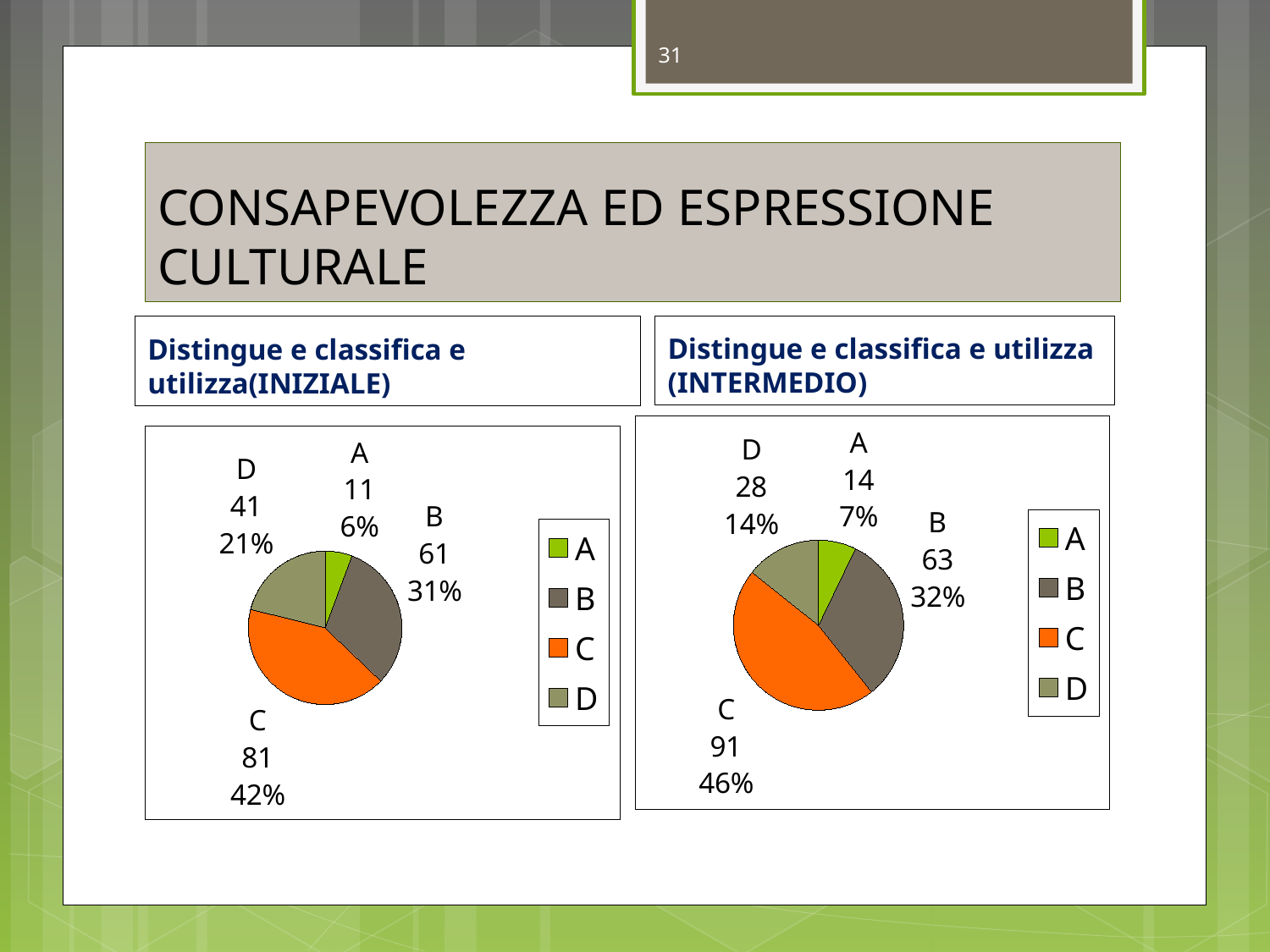
In the right pie chart (INTERMEDIO), which category has the smallest slice? A What colour is the slice for category C in the right pie chart (INTERMEDIO)? Orange In the left pie chart (INIZIALE), which is larger, the value for B or the value for D? B In the right pie chart (INTERMEDIO), what is the value for category A? 14 In the right pie chart (INTERMEDIO), what percentage share does category D have? 14% In the right pie chart (INTERMEDIO), what is the difference between the values for C and B? 28 In the left pie chart (INIZIALE), which category has the largest slice? C How many categories does the left pie chart (INIZIALE) show? 4 In the left pie chart (INIZIALE), what is the percentage share of category A? 6% What type of chart is used on the left (INIZIALE)? Pie chart In the left pie chart (INIZIALE), what is the value for category C? 81 How many entries does the legend of the right pie chart (INTERMEDIO) list? 4